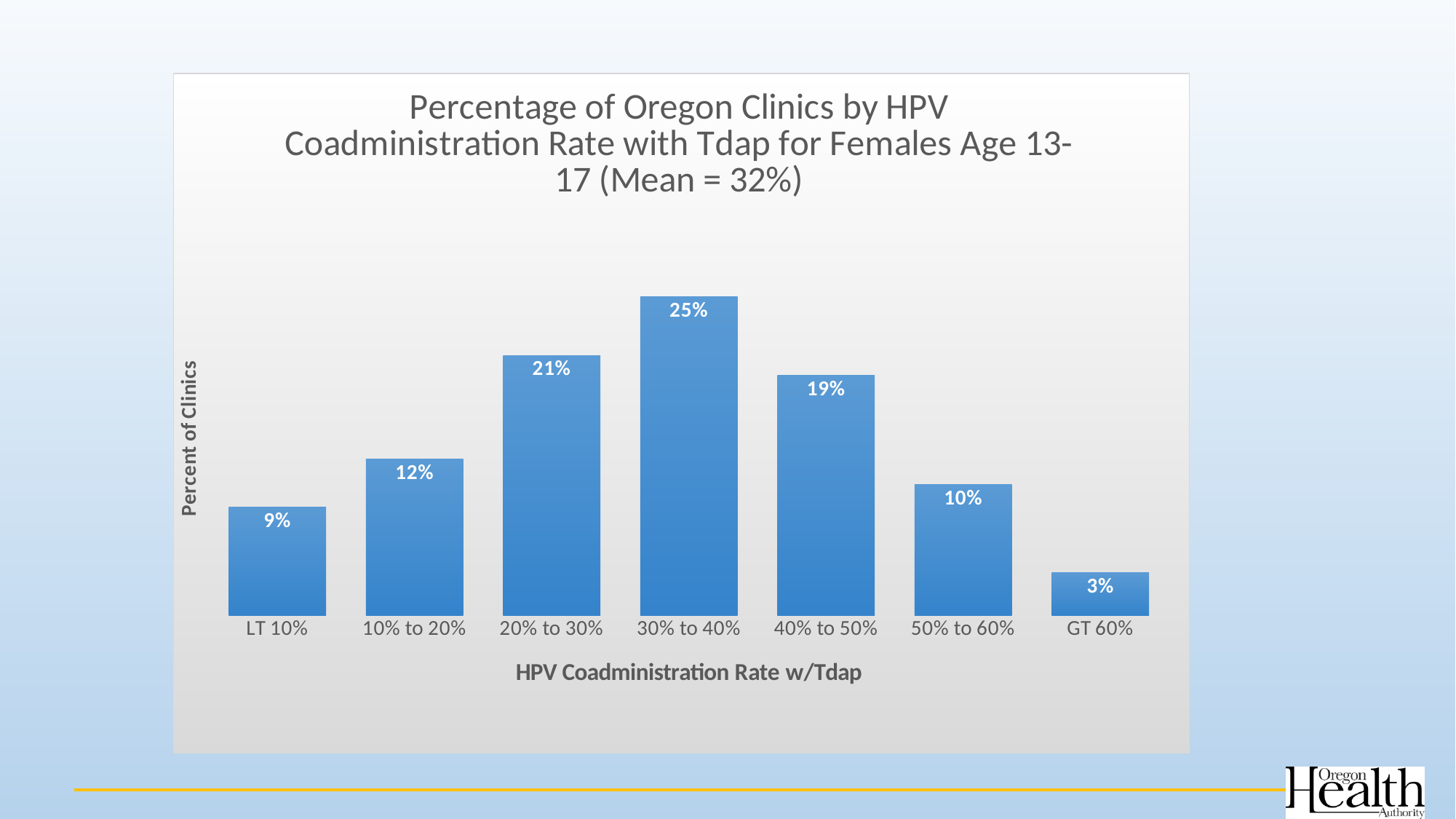
What type of chart is shown on the slide? Bar chart What percentage of clinics have an HPV coadministration rate of 30% to 40%? 25% Which coadministration rate category has the highest percentage of clinics? 30% to 40% What is the difference between the percentage of clinics in the 20% to 30% category and the 10% to 20% category? 9% Which coadministration rate category has the lowest percentage of clinics? GT 60% What is the label of the x axis? HPV Coadministration Rate w/Tdap What is the mean HPV coadministration rate stated in the chart title? 32% What is the value for the GT 60% category? 3% How many coadministration rate categories are shown on the x axis? 7 What percentage of clinics fall in the LT 10% category? 9% What percentage of clinics have a coadministration rate of 40% to 50%? 19% Which category has a larger percentage of clinics: 50% to 60% or LT 10%? 50% to 60%